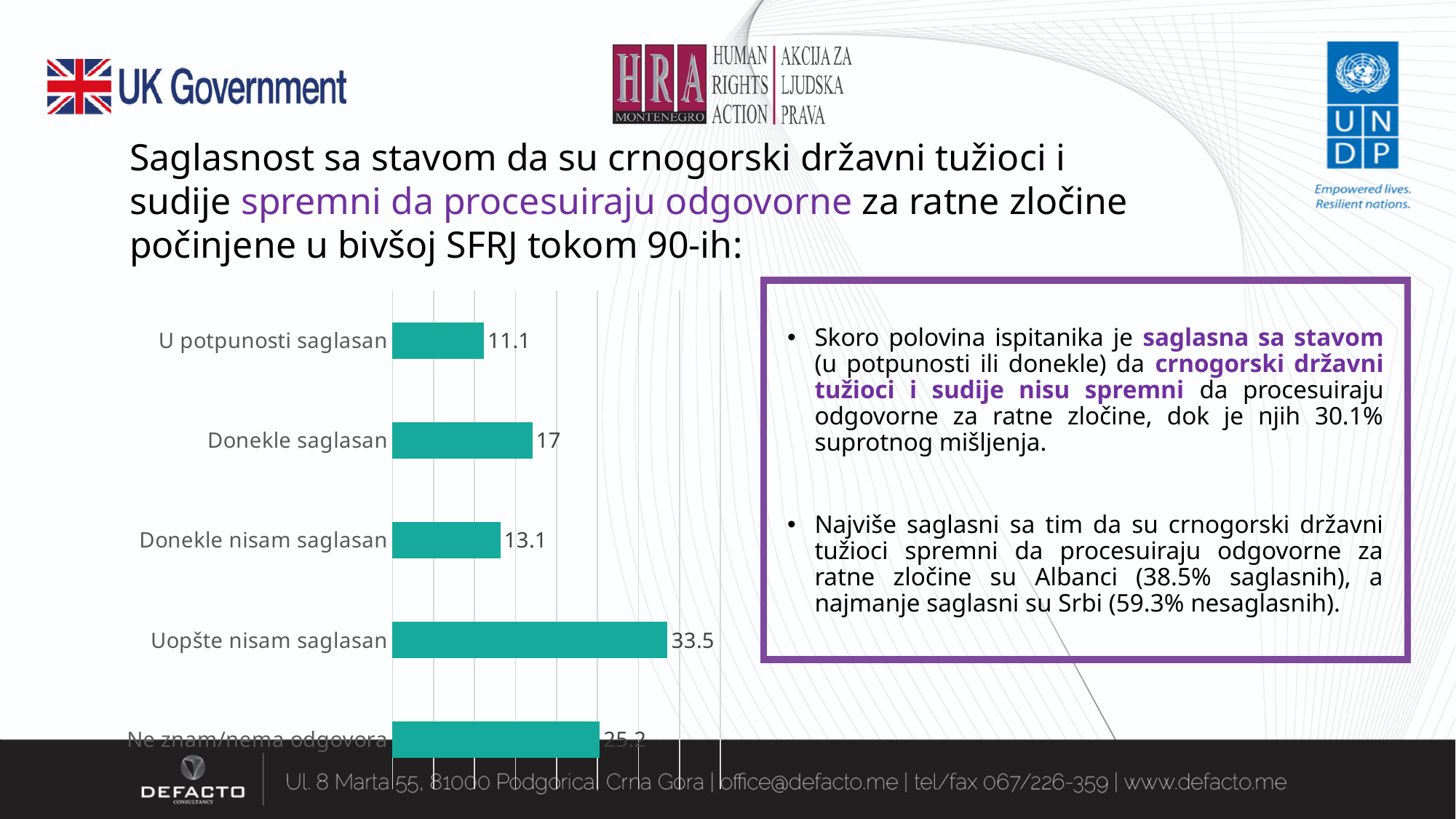
What is the difference between the values for "Donekle saglasan" and "U potpunosti saglasan"? 5.9 What is the value for "Uopšte nisam saglasan"? 33.5 What is the value for "Donekle saglasan"? 17 Which category has the highest value? Uopšte nisam saglasan Which category has the lowest value? U potpunosti saglasan Which is larger, the value for "Ne znam/nema odgovora" or the value for "Uopšte nisam saglasan"? Uopšte nisam saglasan What is the difference between the values for "Uopšte nisam saglasan" and "Donekle saglasan"? 16.5 Which is larger, the value for "Donekle saglasan" or the value for "Donekle nisam saglasan"? Donekle saglasan What kind of chart is shown on the slide? Bar chart What is the value for "U potpunosti saglasan"? 11.1 How many categories are shown in the chart? 5 What is the value for "Donekle nisam saglasan"? 13.1